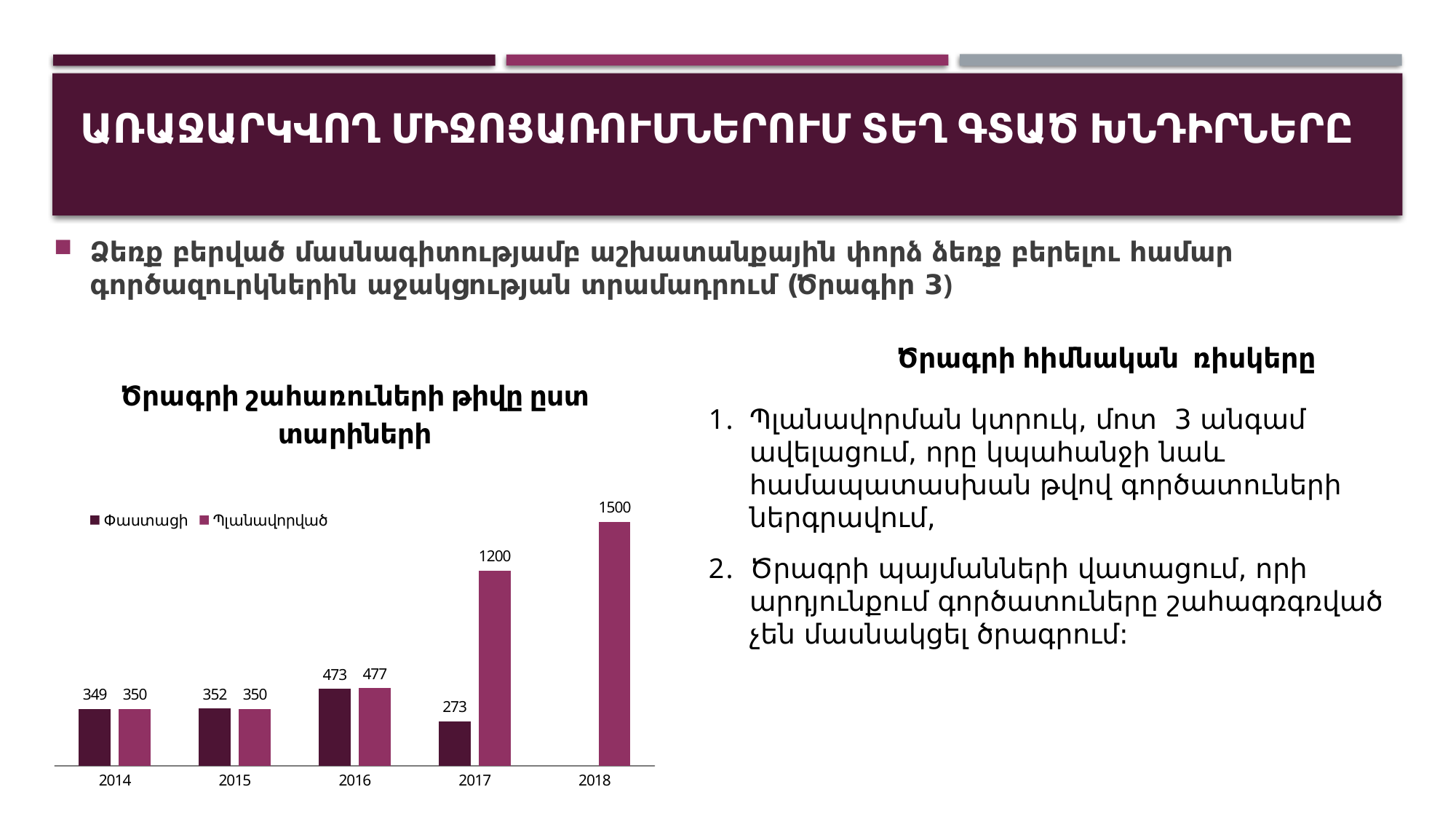
How many years are shown on the x axis? 5 What is the Փաստացի value for 2014? 349 What is the Փաստացի value for 2016? 473 Which is larger for 2015, the Փաստացի value or the Պլանավորված value? Փաստացի What is the title of the chart? Ծրագրի շահառուների թիվը ըստ տարիների What is the Պլանավորված value for 2017? 1200 Which year has the highest Պլանավորված value? 2018 What is the Պլանավորված value for 2018? 1500 How many series does the legend list? 2 Which year has the lowest Փաստացի value? 2017 What kind of chart is shown on the slide? bar chart What is the difference between the Պլանավորված and Փաստացի values for 2017? 927